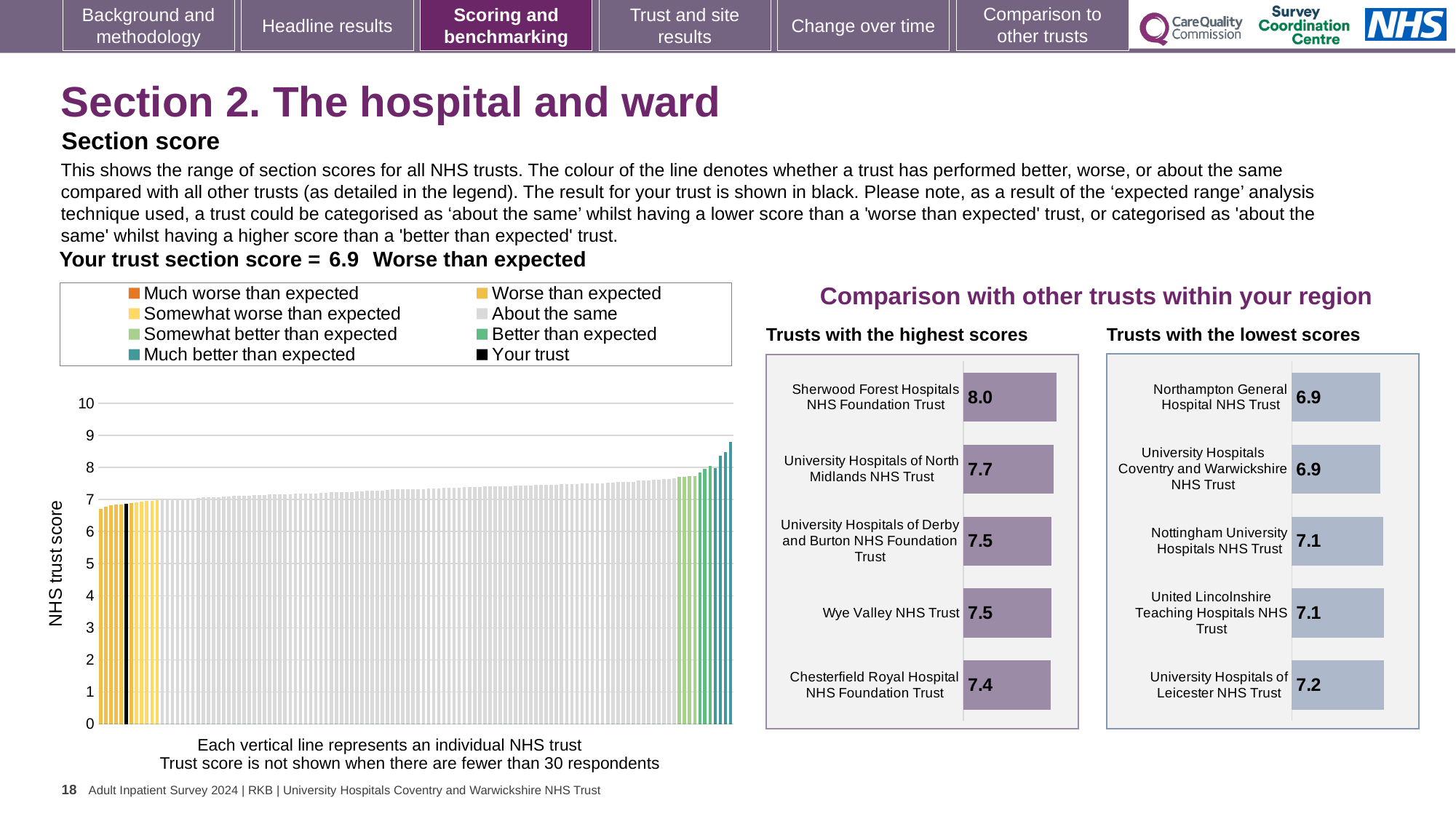
In the 'Trusts with the lowest scores' chart, what is the score for University Hospitals of Leicester NHS Trust? 7.2 In the 'Trusts with the lowest scores' chart, what is the difference between the scores of University Hospitals of Leicester NHS Trust and Northampton General Hospital NHS Trust? 0.3 In the 'Trusts with the lowest scores' chart, which trust has the highest score? University Hospitals of Leicester NHS Trust In the 'Trusts with the highest scores' chart, which has the higher score: University Hospitals of North Midlands NHS Trust or Wye Valley NHS Trust? University Hospitals of North Midlands NHS Trust In the 'Trusts with the highest scores' chart, what is the score for Chesterfield Royal Hospital NHS Foundation Trust? 7.4 In the 'Trusts with the highest scores' chart, which trust has the highest score? Sherwood Forest Hospitals NHS Foundation Trust In the 'Trusts with the highest scores' chart, what is the score for Sherwood Forest Hospitals NHS Foundation Trust? 8.0 In the 'Trusts with the highest scores' chart, what is the difference between the scores of Sherwood Forest Hospitals NHS Foundation Trust and Chesterfield Royal Hospital NHS Foundation Trust? 0.6 How many entries does the legend of the large chart on the left list? 8 What kind of chart is the large chart on the left showing NHS trust scores? Bar chart How many trusts are shown in the 'Trusts with the lowest scores' chart? 5 In the large chart on the left, is the value of the tallest bar greater or less than 8? greater